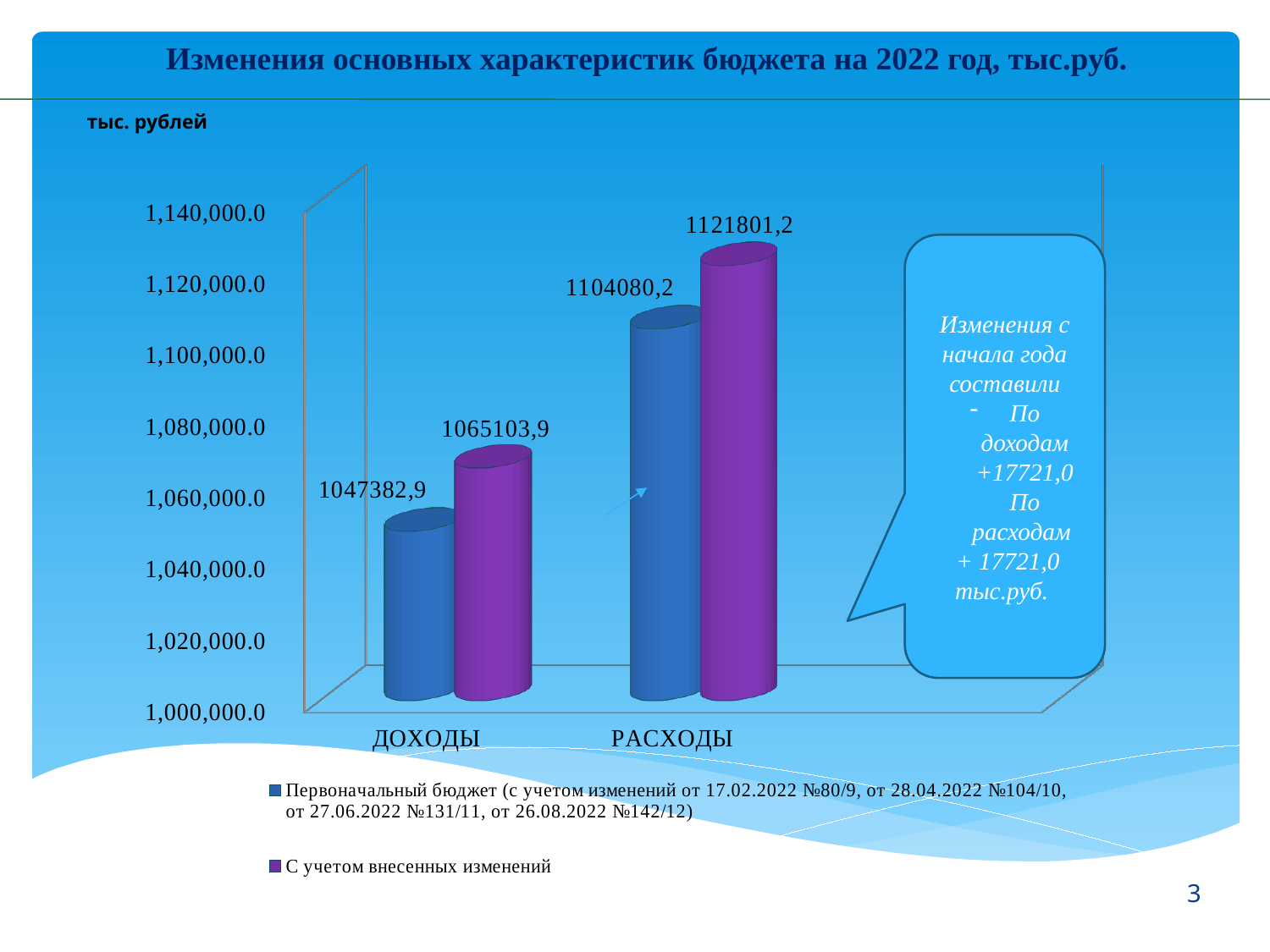
What is the difference between the 'С учетом внесенных изменений' and 'Первоначальный бюджет' values for РАСХОДЫ? 17721,0 What is the value for ДОХОДЫ in the series 'С учетом внесенных изменений'? 1065103,9 Which category has the lowest value in the series 'Первоначальный бюджет'? ДОХОДЫ What is the value for ДОХОДЫ in the series 'Первоначальный бюджет'? 1047382,9 What is the value for РАСХОДЫ in the series 'С учетом внесенных изменений'? 1121801,2 How many categories are shown on the x axis of the chart? 2 What is the title of the chart on the slide? Изменения основных характеристик бюджета на 2022 год, тыс.руб. What is the value for РАСХОДЫ in the series 'Первоначальный бюджет'? 1104080,2 Which is larger: the 'Первоначальный бюджет' value for РАСХОДЫ or the 'С учетом внесенных изменений' value for ДОХОДЫ? Первоначальный бюджет value for РАСХОДЫ Which category has the highest value in the series 'С учетом внесенных изменений'? РАСХОДЫ What type of chart is shown on the slide? bar chart How many series does the chart legend list? 2